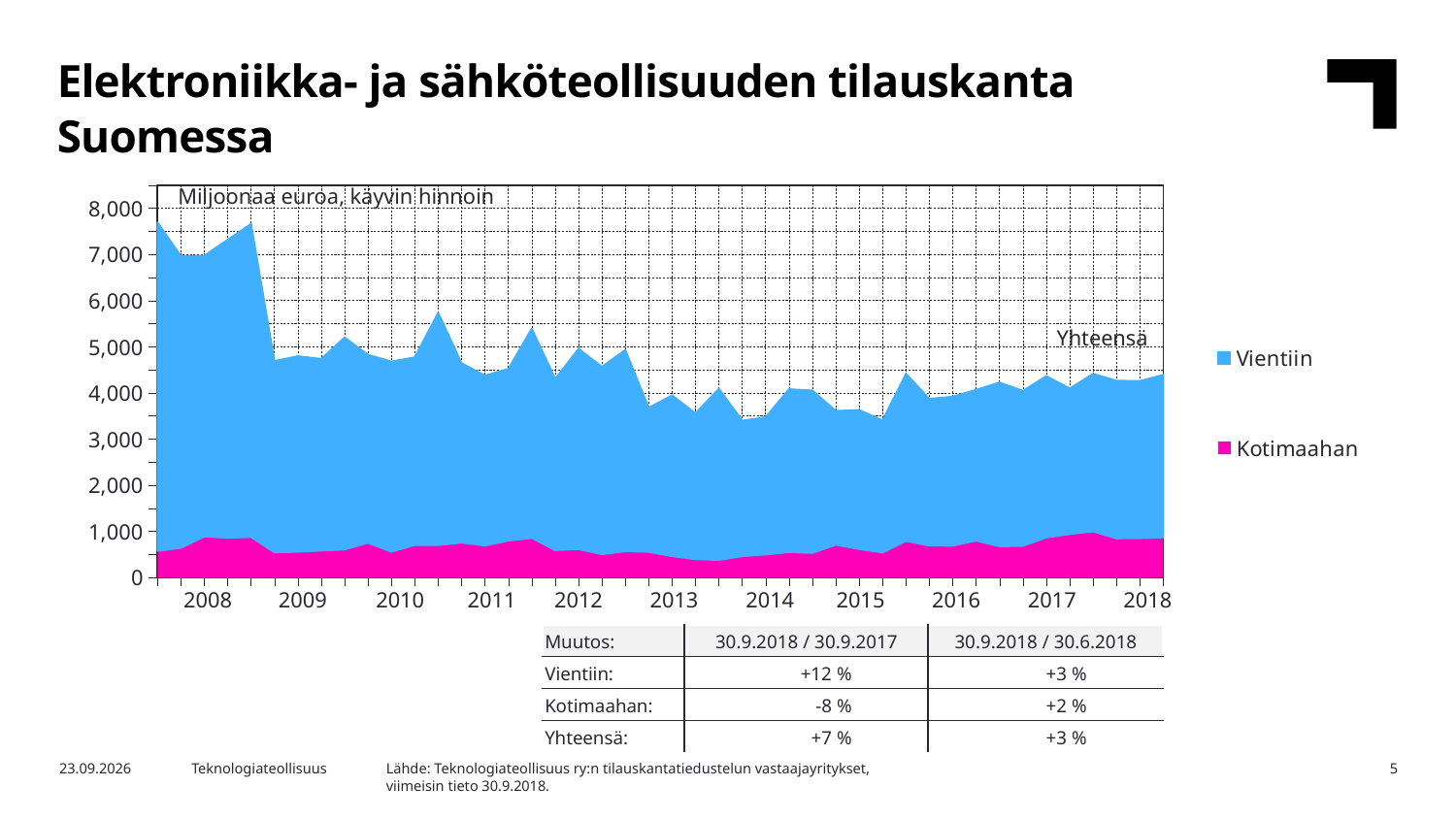
Is the Kotimaahan value in 2013 greater or less than 1,000? less In which year shown on the x axis is the total order backlog at its highest? 2008 Does the total order backlog (Yhteensä) overall rise or fall from 2008 to 2018? fall What kind of chart is shown on the slide? Stacked area chart What are the two series named in the chart legend? Vientiin and Kotimaahan Is the total order backlog (Yhteensä) at the start of 2015 greater or less than 4,000? less Is the total order backlog (Yhteensä) in 2018 greater or less than 5,000? less How many years are labelled on the x axis of the chart? 11 What unit is stated at the top of the chart? Miljoonaa euroa, käyvin hinnoin How many series does the chart legend list? 2 Which series is larger in 2018, Vientiin or Kotimaahan? Vientiin